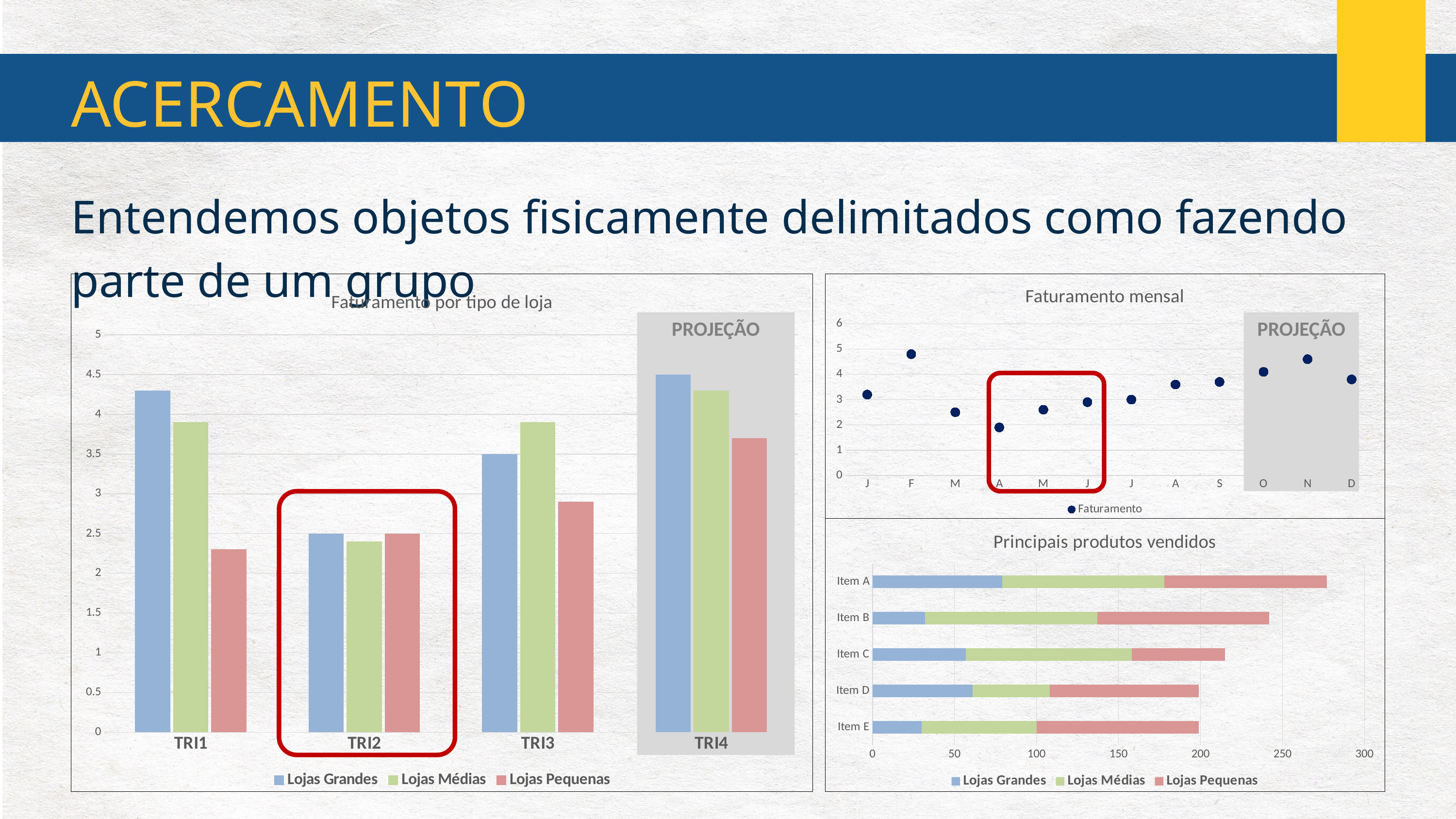
In the chart 'Faturamento por tipo de loja', what kind of chart is it? bar chart In the chart 'Faturamento por tipo de loja', is the value for Lojas Grandes in TRI1 greater or less than 4? greater In the chart 'Faturamento por tipo de loja', in TRI3, which is larger: Lojas Grandes or Lojas Médias? Lojas Médias In the chart 'Faturamento por tipo de loja', how many categories are shown on the x axis? 4 In the chart 'Faturamento mensal', which month has the lowest value? A In the chart 'Faturamento por tipo de loja', how many series does the legend list? 3 In the chart 'Faturamento mensal', is the value for F greater or less than 4? greater In the chart 'Principais produtos vendidos', is the total for Item B greater or less than 200? greater In the chart 'Faturamento por tipo de loja', which category is marked as PROJEÇÃO? TRI4 In the chart 'Principais produtos vendidos', which item has the largest total bar? Item A In the chart 'Faturamento por tipo de loja', which category has the lowest value for Lojas Grandes? TRI2 In the chart 'Faturamento mensal', how many data points are plotted? 12